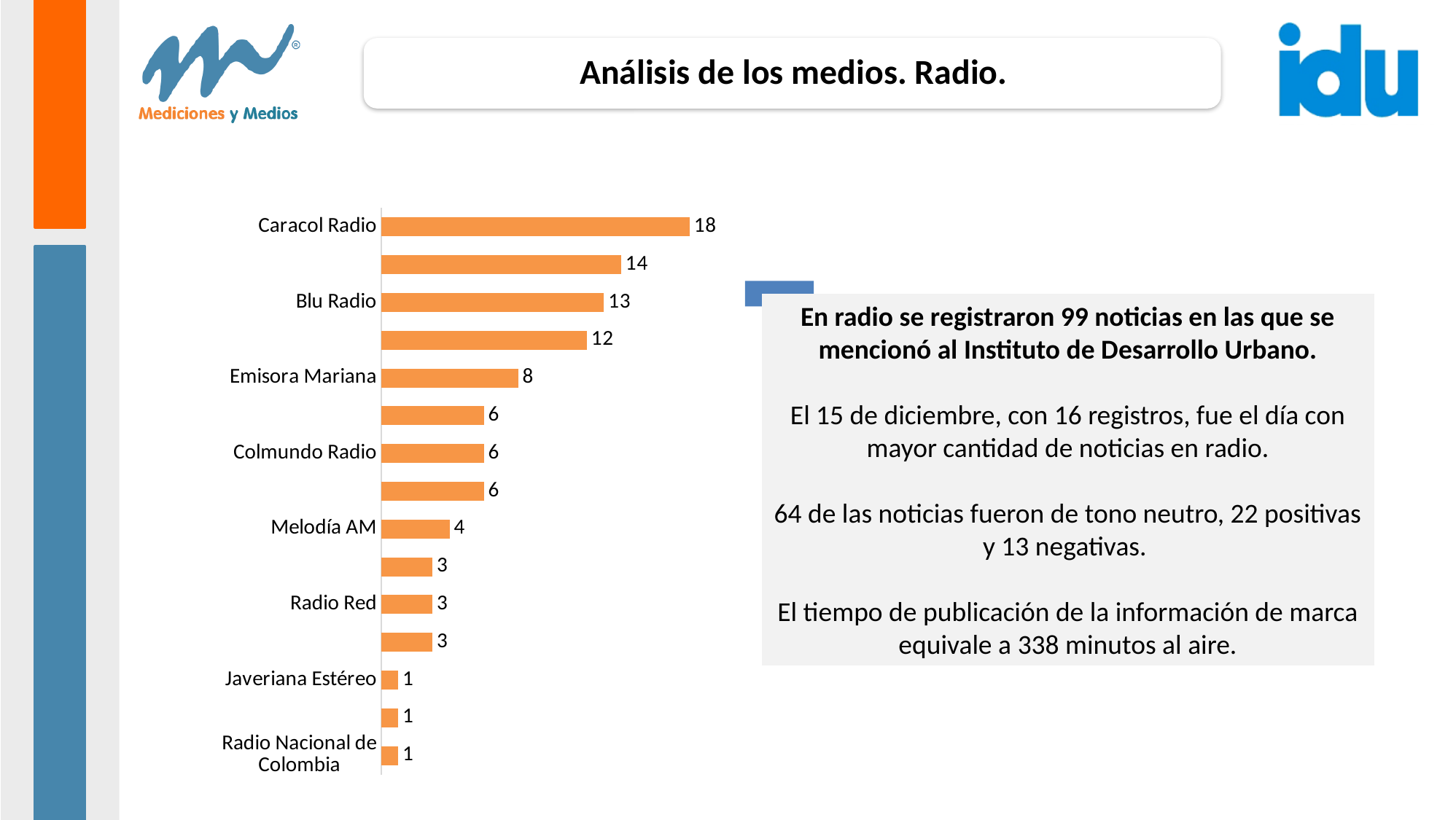
Which is larger, the value for Colmundo Radio or the value for Radio Red? Colmundo Radio What type of chart is shown on the slide? bar chart What is the difference between the values for Caracol Radio and Blu Radio? 5 What is the value for Blu Radio? 13 What colour are the bars in the chart? orange How many bars are plotted in the chart? 15 Which category has the highest value in the chart? Caracol Radio What is the value for Radio Nacional de Colombia? 1 What is the value for Emisora Mariana? 8 What is the value for Caracol Radio? 18 What is the value for Melodía AM? 4 What is the difference between the values for Emisora Mariana and Melodía AM? 4